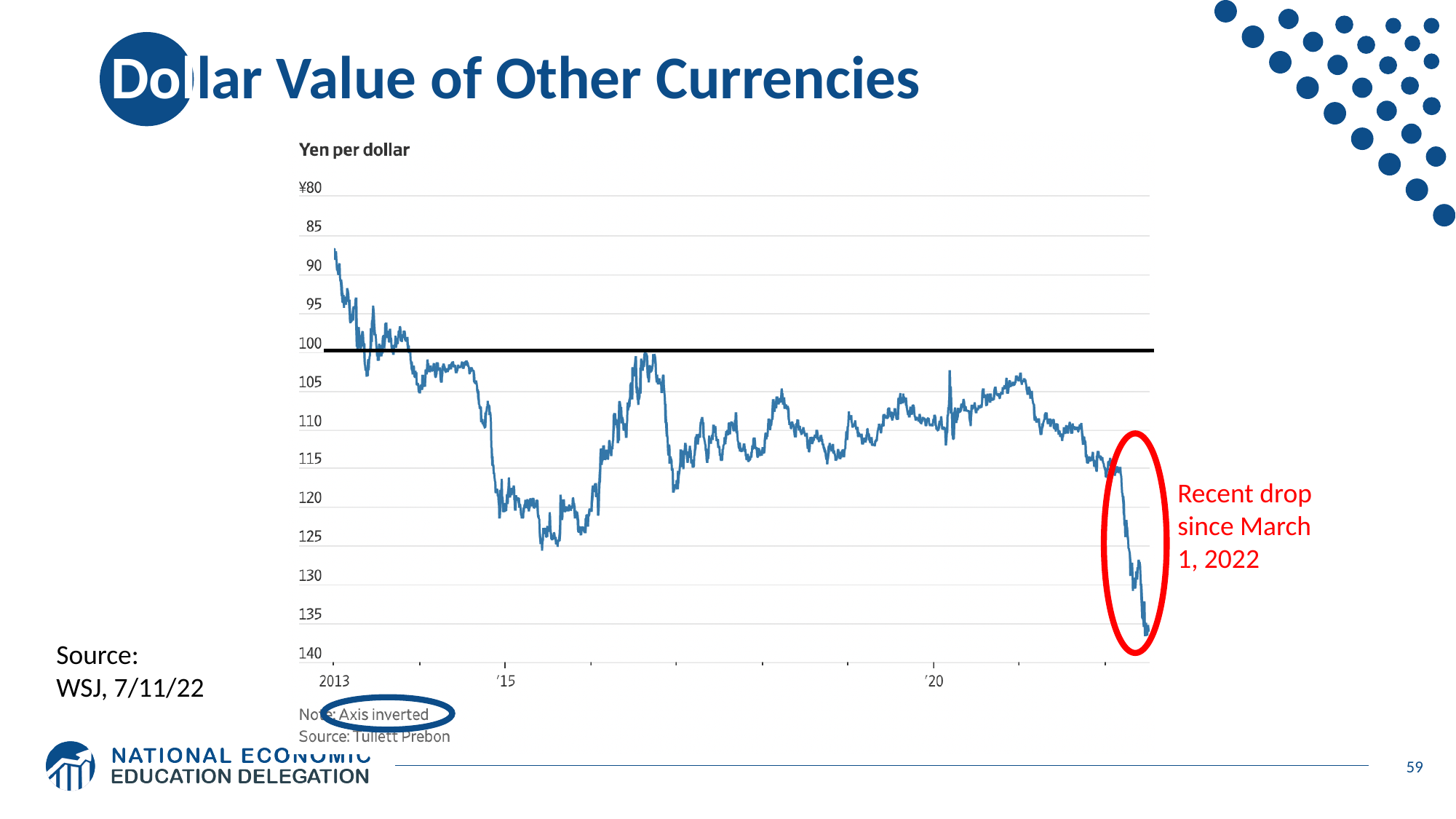
Is the yen per dollar value at the '15 tick mark greater or less than 110? greater Is the yen per dollar value at the '20 tick mark greater or less than 100? greater Does the yen per dollar value rise or fall from the start of 2013 to the end of the line in 2022? rise What kind of chart is shown on the slide? line chart What does the note below the chart say about the axis? Axis inverted Does the yen per dollar value rise or fall between March 2022 and the end of the line? rise How many data series are plotted in the chart? 1 Is the yen per dollar value at the end of the line (mid-2022) greater or less than 130? greater How many year labels are printed on the x axis? 3 Which is larger, the yen per dollar value at the start of 2013 or at the end of the line in 2022? end of the line in 2022 What is the title printed above the chart's y axis? Yen per dollar